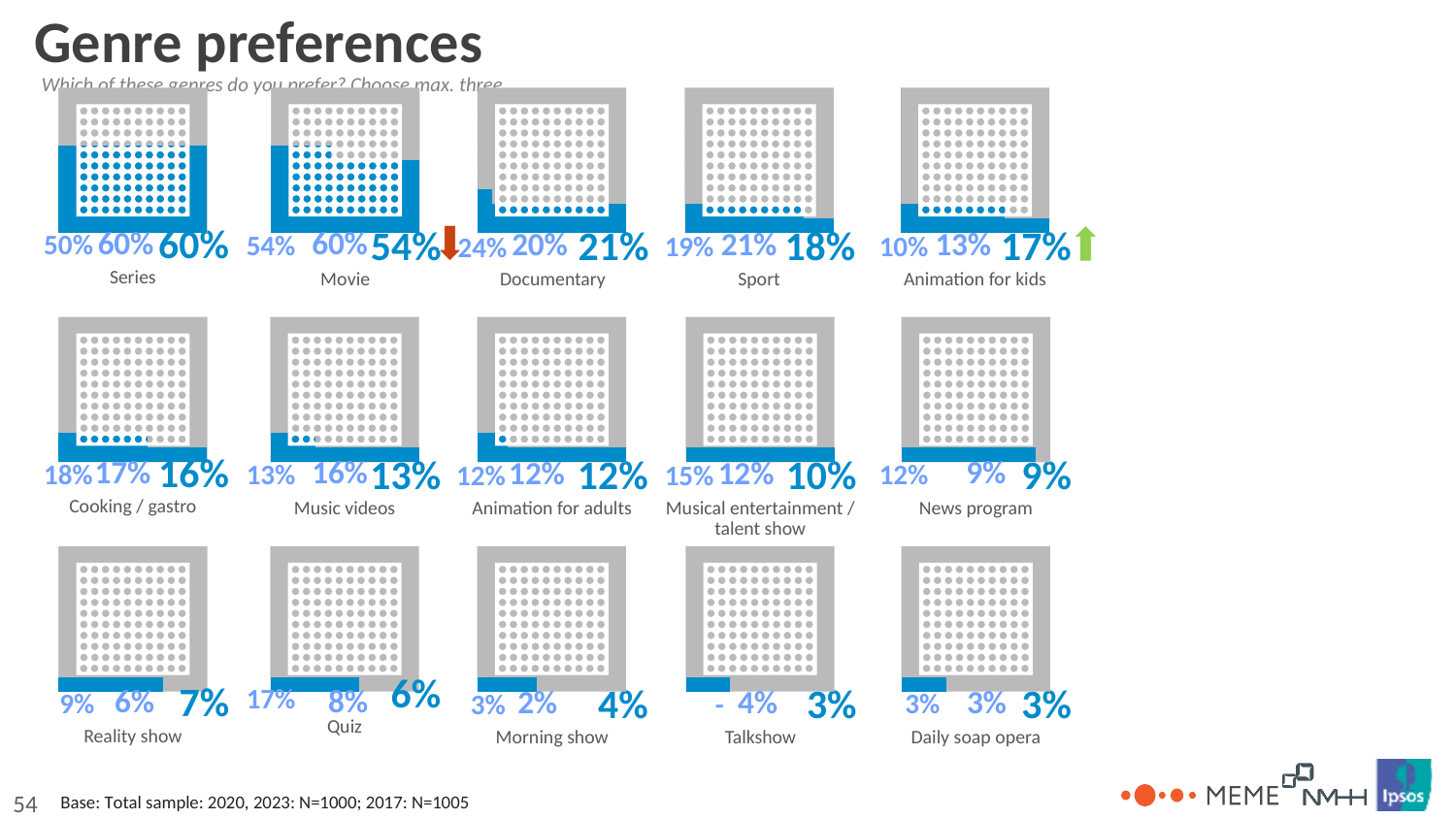
Do the three values for Quiz rise or fall from left to right? Fall Do the three values for Animation for kids rise or fall from left to right? Rise Which genre has the highest large bold value? Series What is the difference between the large bold values for Series and Movie? 6 percentage points Which has the larger large bold value, Documentary or Sport? Documentary What kind of chart is used to show each genre's preference? Waffle chart (dot grid) Which genre is marked with a red downward arrow? Movie What is the large bold value shown for Documentary? 21% What is the large bold value shown for Series? 60% What is the leftmost (smallest-font) value shown for Quiz? 17% How many genres are shown on the slide? 15 What is the large bold value shown for Animation for kids? 17%